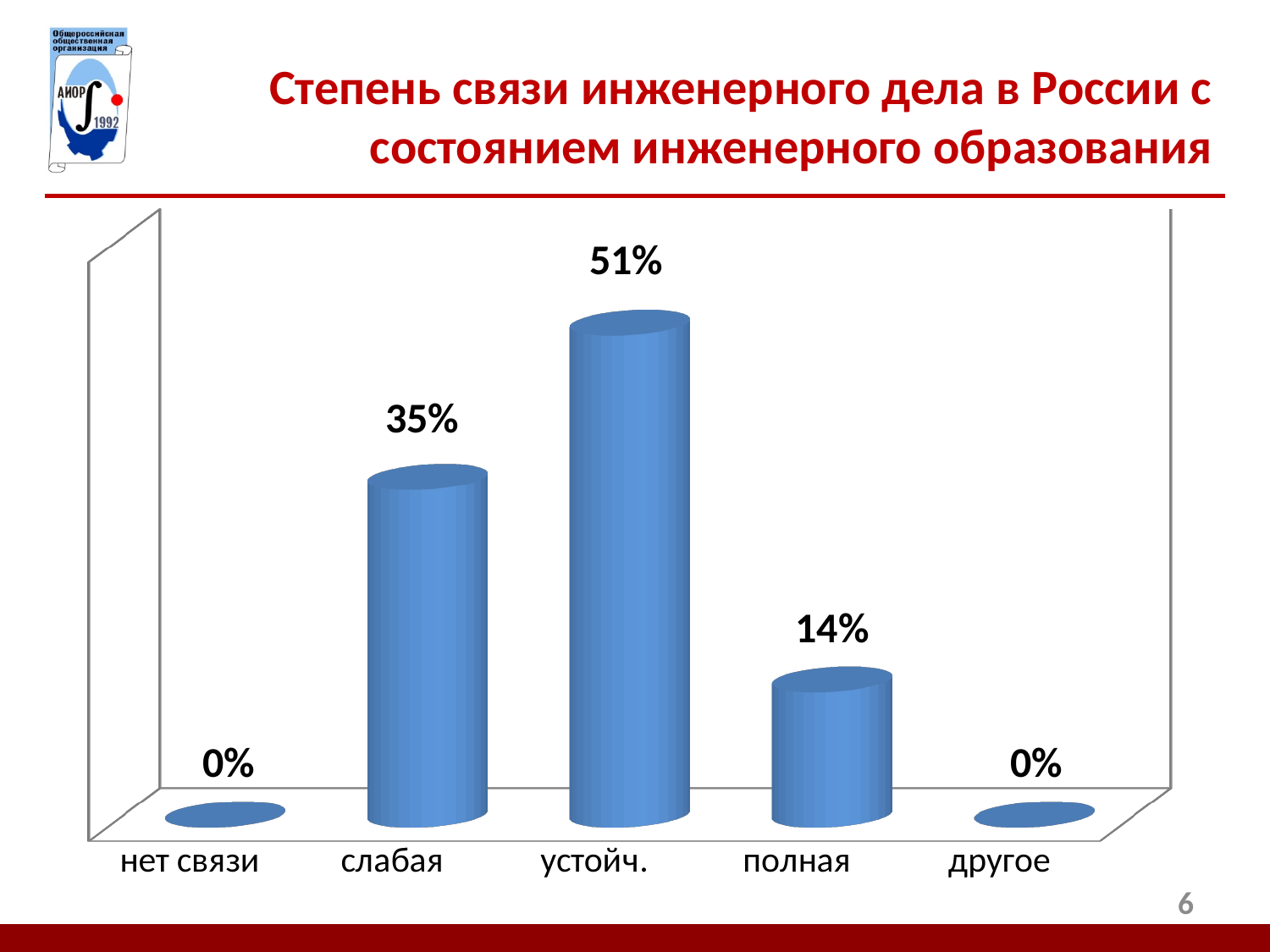
How many categories are shown on the x axis? 5 What kind of chart is shown on the slide? bar chart What is the difference between the values for "устойч." and "слабая"? 16% What is the value for "нет связи"? 0% What is the value for "полная"? 14% How many categories have a value of 0%? 2 What is the value for "устойч."? 51% What is the value for "слабая"? 35% What is the title of the slide? Степень связи инженерного дела в России с состоянием инженерного образования Which is larger, the value for "слабая" or the value for "полная"? слабая What is the difference between the values for "слабая" and "полная"? 21% Which category has the highest value? устойч.